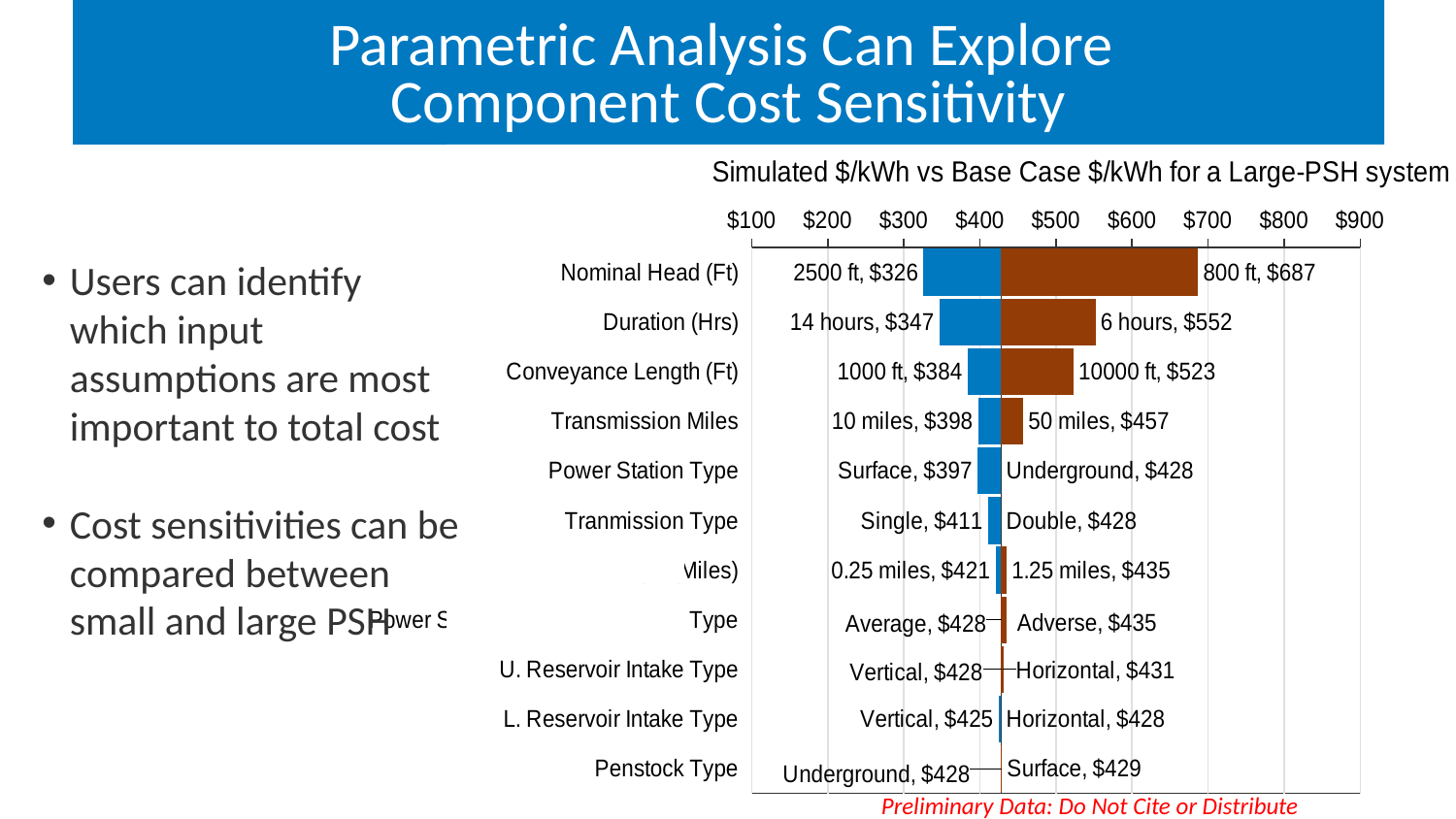
What is the title of the chart? Simulated $/kWh vs Base Case $/kWh for a Large-PSH system How many input parameters (bars) are shown on the chart? 11 What is the simulated $/kWh value for the 10000 ft Conveyance Length case? $523 What is the difference between the 800 ft and 2500 ft Nominal Head values? $361 Which input parameter has the lowest simulated $/kWh value on the chart? Nominal Head (Ft) Which is larger: the value for 50 miles of Transmission Miles or the value for an Underground Power Station Type? 50 miles, $457 What is the simulated $/kWh value for the 800 ft Nominal Head case? $687 What is the simulated $/kWh value for the Surface Penstock Type case? $429 What is the difference between the 6 hours and 14 hours Duration values? $205 What is the simulated $/kWh value for the 14 hours Duration case? $347 Which input parameter has the highest simulated $/kWh value on the chart? Nominal Head (Ft) What kind of chart is shown on the slide? Bar chart